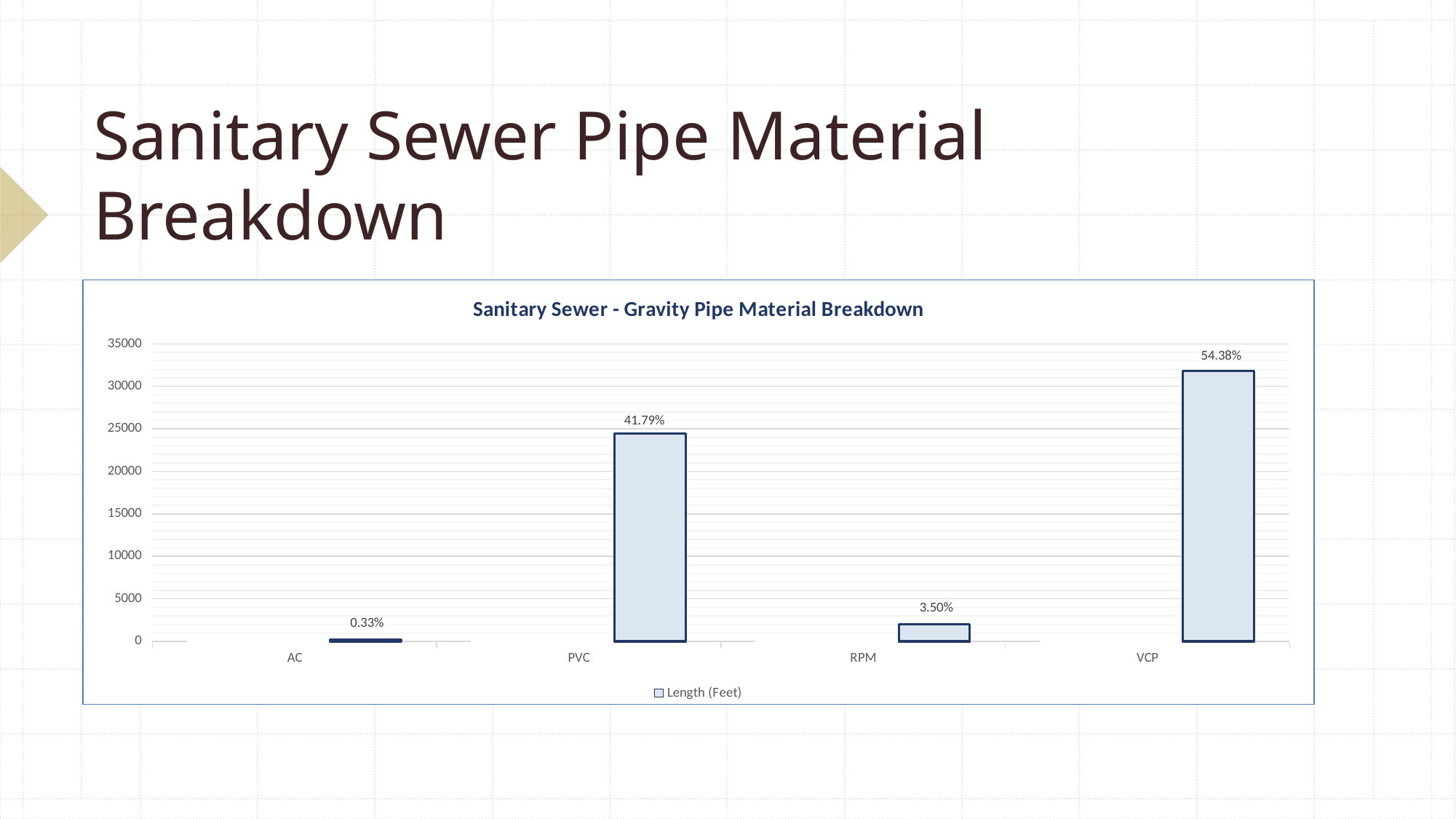
What percentage label is shown above the AC bar? 0.33% Which pipe material has the highest bar? VCP What percentage label is shown above the VCP bar? 54.38% Which pipe material has the lowest bar? AC How many series does the legend list? 1 What is the title of the chart? Sanitary Sewer - Gravity Pipe Material Breakdown What kind of chart is shown on the slide? bar chart Is the length value for PVC greater or less than 20000? greater What percentage label is shown above the RPM bar? 3.50% What is the legend entry for the series? Length (Feet) What percentage label is shown above the PVC bar? 41.79% How many pipe material categories are shown on the x axis? 4